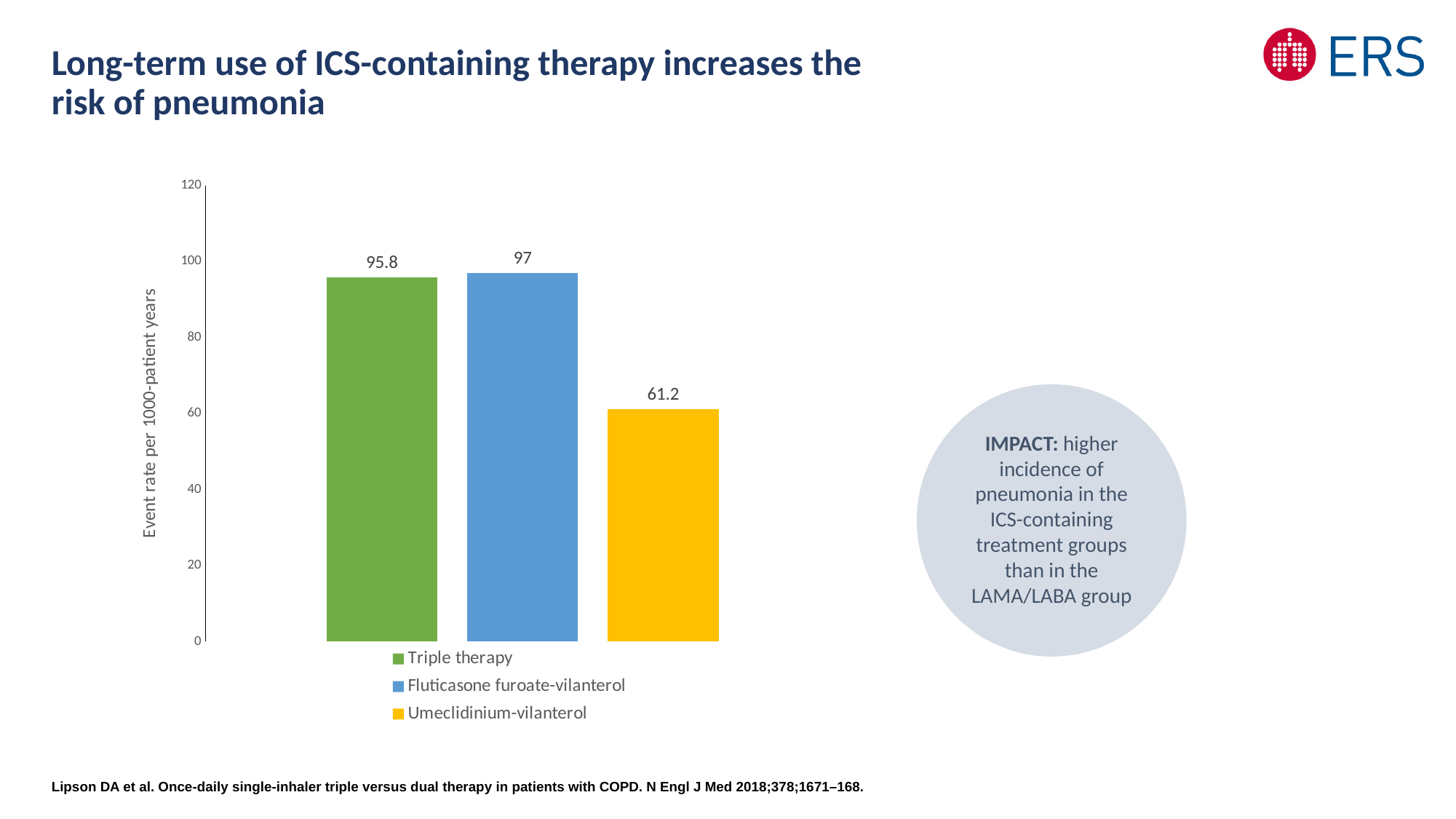
Which has a higher event rate, Triple therapy or Umeclidinium-vilanterol? Triple therapy How many treatment groups are plotted in the chart? 3 What is the event rate per 1000-patient years for Fluticasone furoate-vilanterol? 97 What is the difference in event rate between Fluticasone furoate-vilanterol and Umeclidinium-vilanterol? 35.8 What is the event rate per 1000-patient years for Umeclidinium-vilanterol? 61.2 Is the value for Umeclidinium-vilanterol greater or less than 80? less Which treatment group has the lowest event rate? Umeclidinium-vilanterol Which treatment group has the highest event rate? Fluticasone furoate-vilanterol What is the difference in event rate between Triple therapy and Umeclidinium-vilanterol? 34.6 What is the event rate per 1000-patient years for Triple therapy? 95.8 What kind of chart is shown on the slide? bar chart What is the label of the vertical axis? Event rate per 1000-patient years